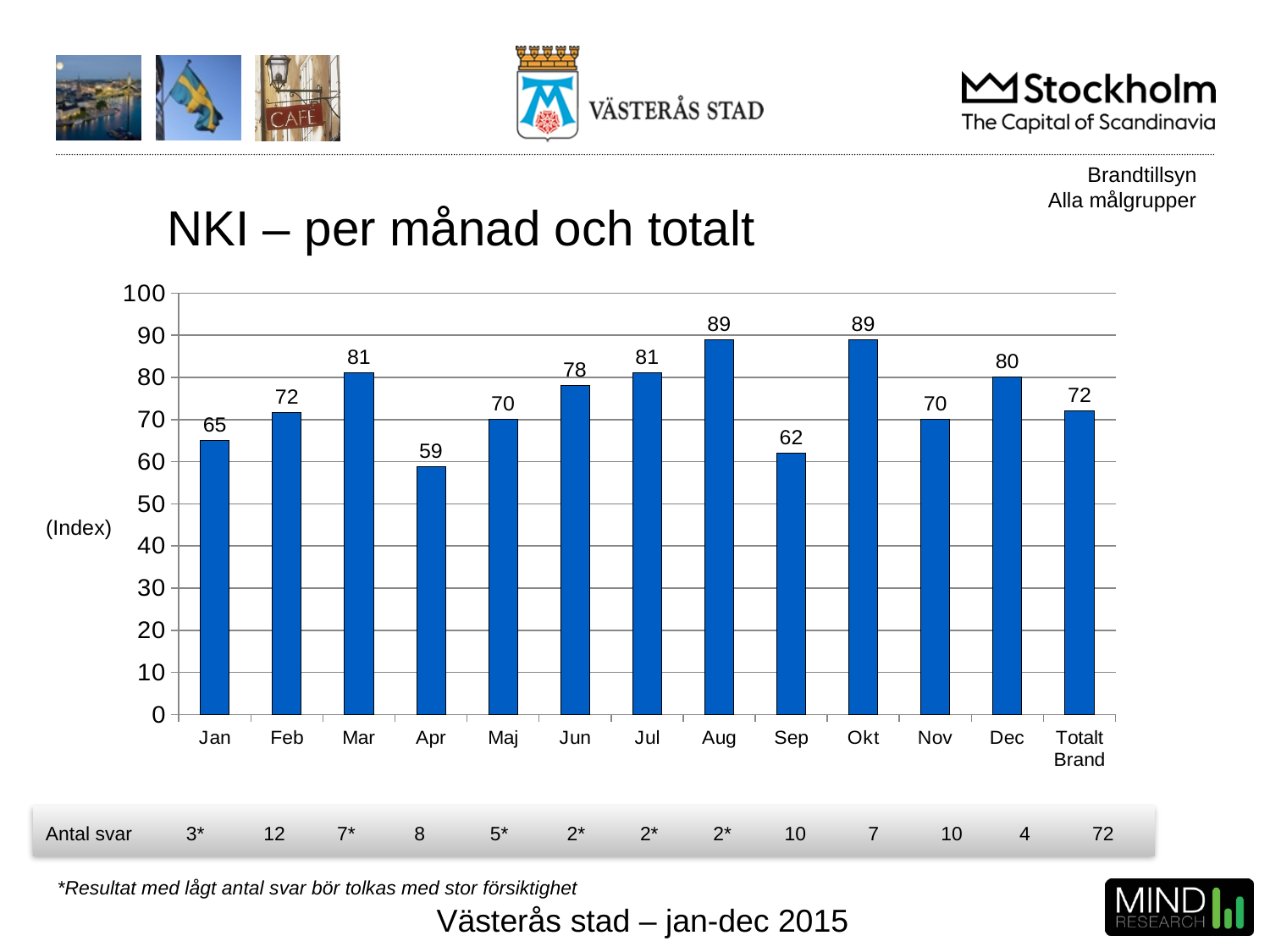
What is the NKI value for Totalt Brand? 72 What is the title of the chart? NKI – per månad och totalt Which has a higher NKI value, Jan or Sep? Jan What is the difference between the NKI values for Aug and Apr? 30 What is the NKI value for Sep? 62 Do the NKI values rise or fall from Jan to Mar? Rise Which has a higher NKI value, Jun or Feb? Jun How many bars are shown in the chart? 13 Which month has the lowest NKI value? Apr What is the difference between the NKI values for Dec and Nov? 10 What is the NKI value for Mar? 81 What kind of chart is shown on the slide? Bar chart